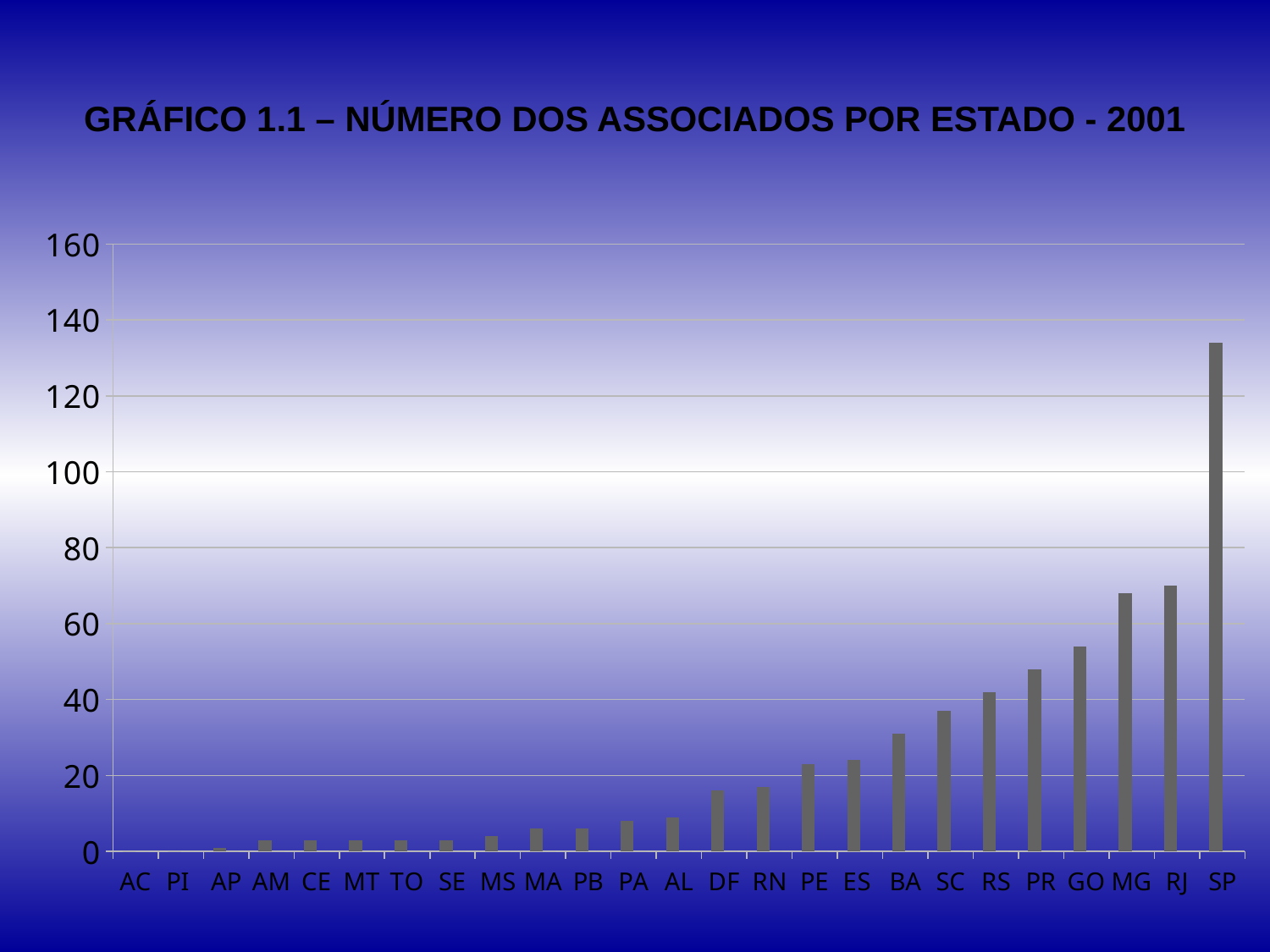
How many states are shown on the x axis? 25 What kind of chart is shown on the slide? bar chart Is the value for DF greater or less than 20? less What is the title of the chart? GRÁFICO 1.1 – NÚMERO DOS ASSOCIADOS POR ESTADO - 2001 Is the value for MG greater or less than 60? greater Do the values rise or fall from left to right along the x axis? rise Is the value for GO greater or less than 60? less Which is larger, the value for SP or the value for RJ? SP Which is larger, the value for BA or the value for DF? BA Which state has the highest number of associates? SP